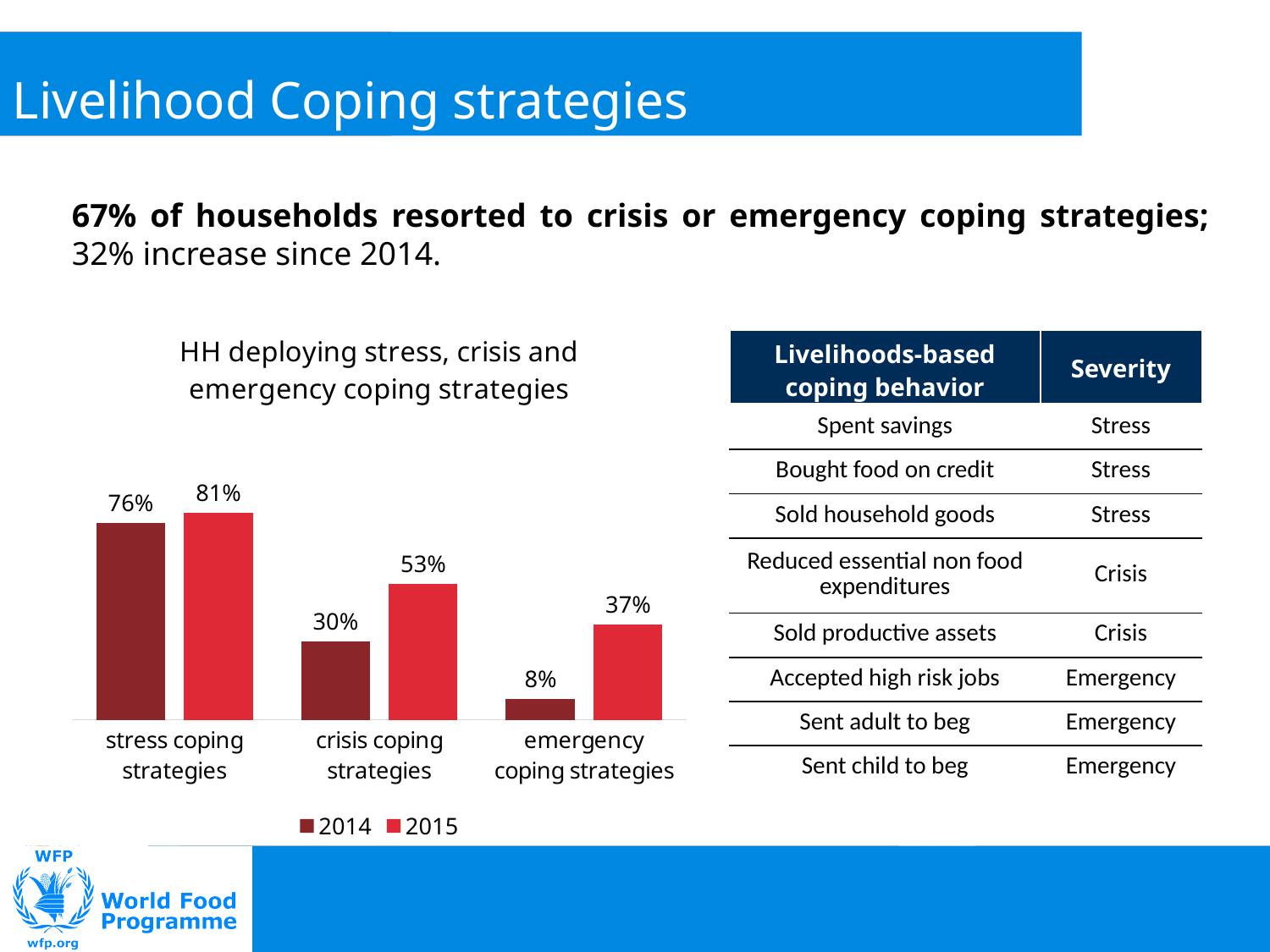
How many series does the chart legend list? 2 What is the difference between the 2015 and 2014 values for crisis coping strategies? 23% Which is larger: the 2015 value for crisis coping strategies or the 2015 value for emergency coping strategies? crisis coping strategies Which category has the highest 2015 value? stress coping strategies What is the 2015 value for crisis coping strategies? 53% What kind of chart is shown on the slide? bar chart How many categories are shown on the x axis of the chart? 3 Which category has the lowest 2014 value? emergency coping strategies What is the 2014 value for stress coping strategies? 76% What is the difference between the 2015 and 2014 values for emergency coping strategies? 29% What is the 2014 value for emergency coping strategies? 8% What is the title of the chart? HH deploying stress, crisis and emergency coping strategies